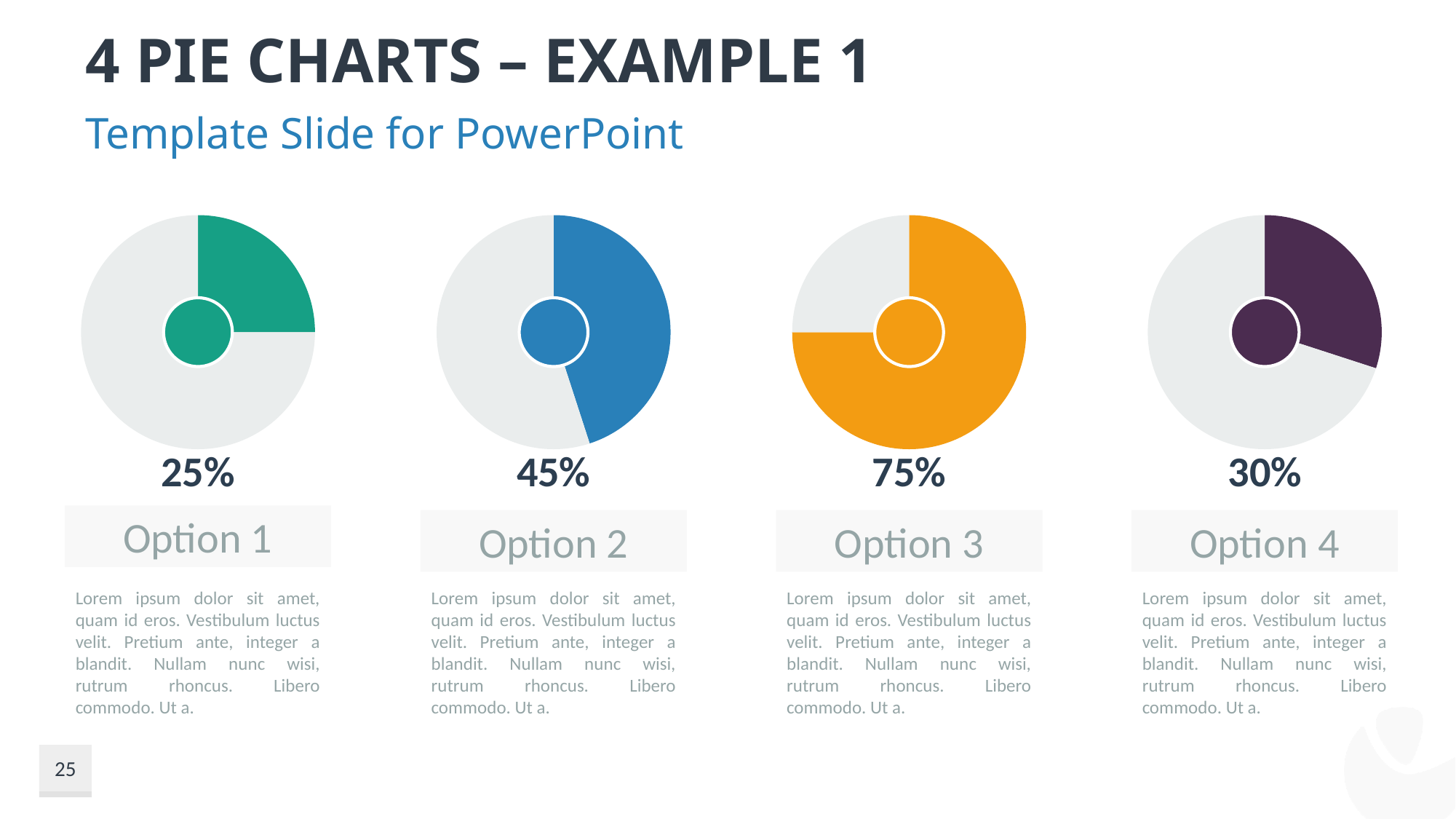
What percentage is shown for the Option 2 pie chart? 45% Across the four pie charts, which option has the highest percentage? Option 3 How many pie charts are shown on the slide? 4 What type of chart is used for each of the four options on the slide? Pie chart What percentage is shown for the Option 1 pie chart? 25% What is the difference between the percentages shown for the Option 3 and Option 1 pie charts? 50% What is the difference between the percentages shown for the Option 2 and Option 4 pie charts? 15% What percentage is shown for the Option 3 pie chart? 75% Across the four pie charts, which option has the lowest percentage? Option 1 What colour is the highlighted slice in the Option 3 pie chart? Orange What percentage is shown for the Option 4 pie chart? 30% Which is larger, the percentage for the Option 2 pie chart or the Option 4 pie chart? Option 2